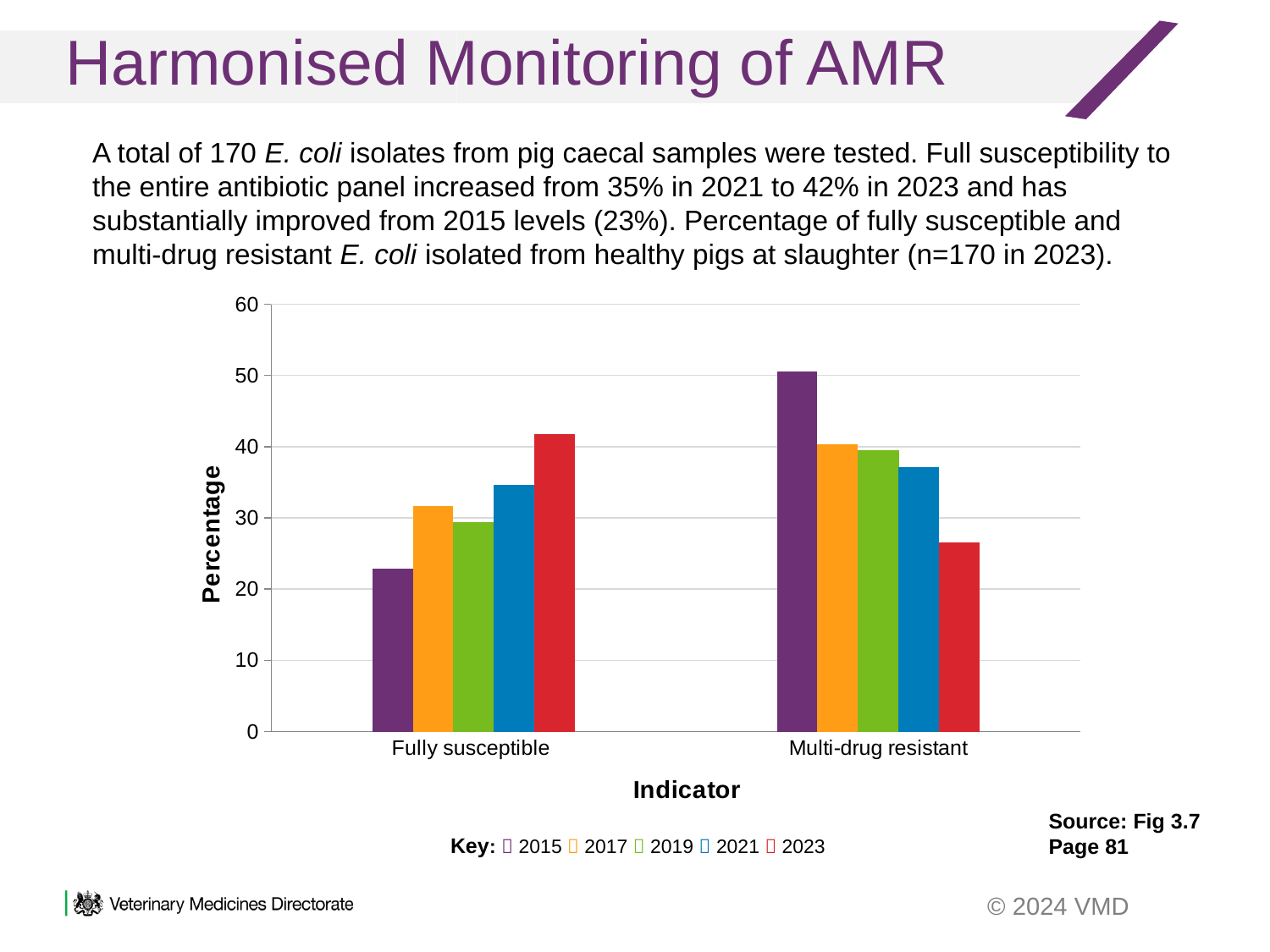
Is the value of the purple bar for Fully susceptible greater or less than 30? less What is the label on the horizontal axis of the chart? Indicator How many series does the key list for the chart? 5 How many categories are shown on the x axis of the chart? 2 What kind of chart is shown on the slide? bar chart Is the value of the red bar for Multi-drug resistant greater or less than 30? less Which bar is the tallest in the Multi-drug resistant group? the purple bar (2015) Which bar is the shortest in the Fully susceptible group? the purple bar (2015) Is the purple bar larger for Fully susceptible or for Multi-drug resistant? Multi-drug resistant Which bar is the shortest in the Multi-drug resistant group? the red bar (2023) Which bar is the tallest in the Fully susceptible group? the red bar (2023) What is the label on the vertical axis of the chart? Percentage